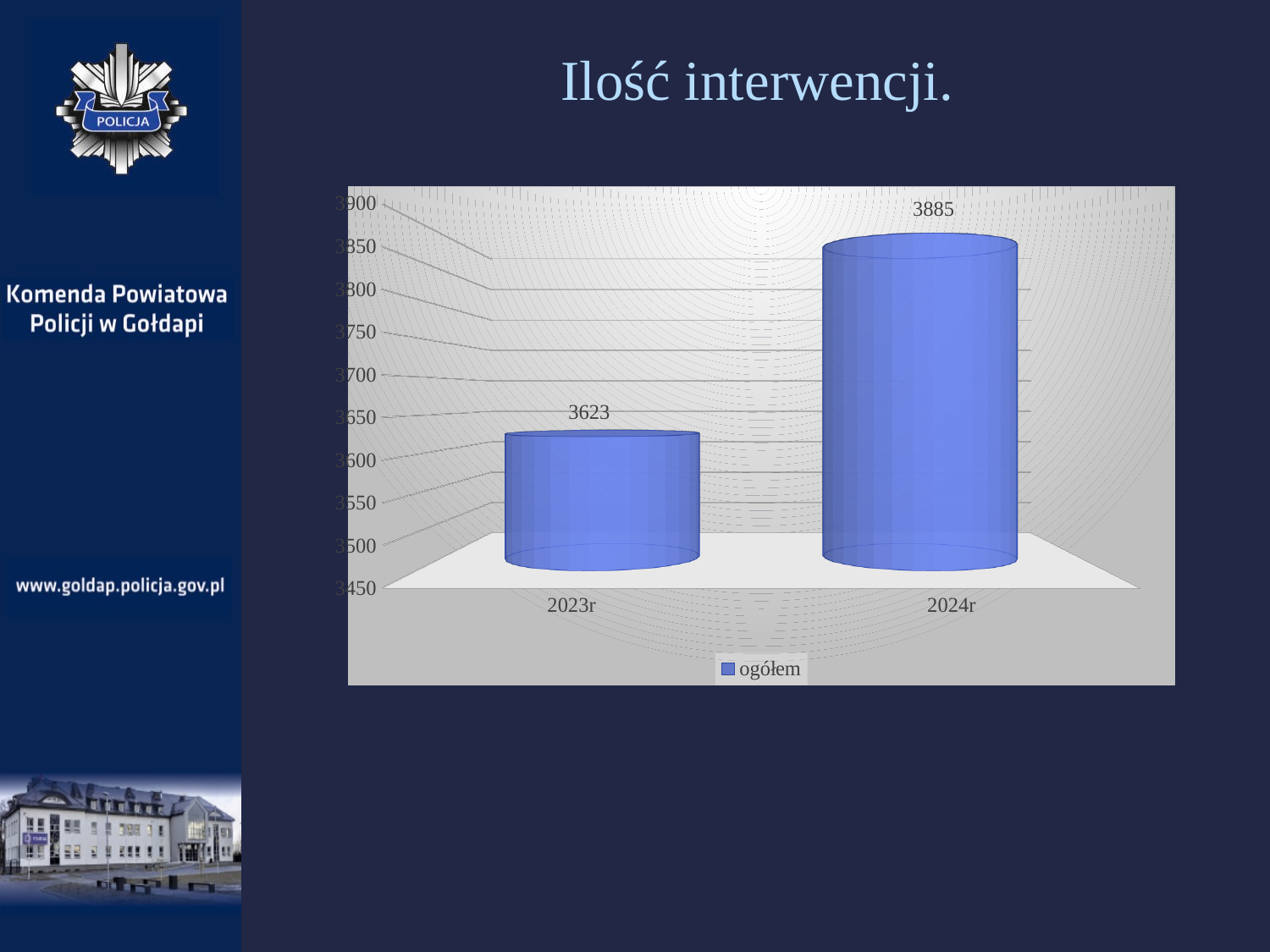
What is the value for 2023r? 3623 How many series does the legend list? 1 Which year has the higher number of interventions? 2024r What is the difference between the values for 2024r and 2023r? 262 What is the title of the chart? Ilość interwencji. Is the value for 2024r larger or smaller than the value for 2023r? larger Which year has the lower number of interventions? 2023r How many categories are shown on the x axis? 2 Is the value for 2023r greater or less than 3700? less Is the value for 2024r greater or less than 3800? greater What kind of chart is shown on the slide? bar chart What is the value for 2024r? 3885